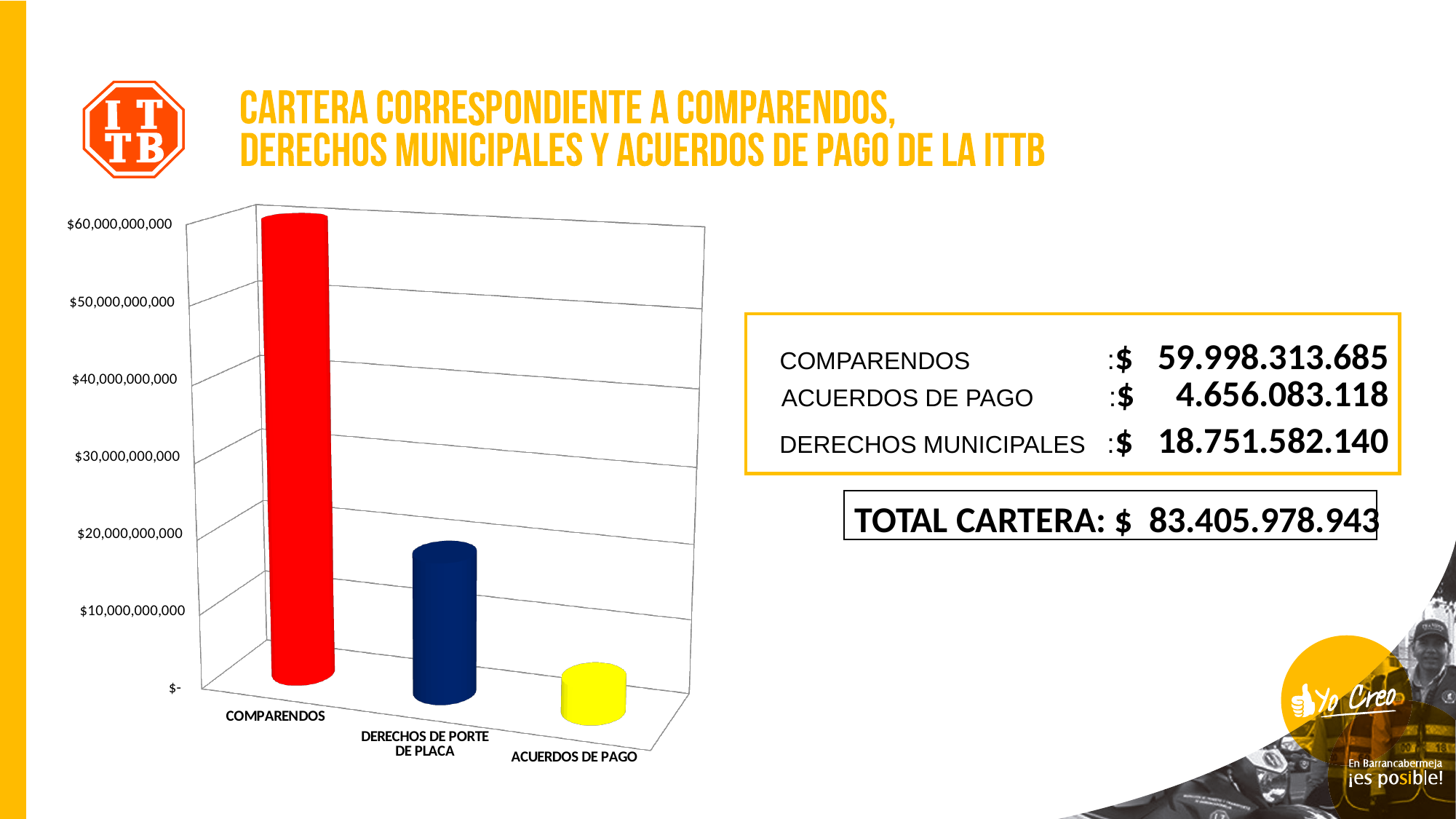
Which category has the lowest bar in the chart? ACUERDOS DE PAGO Which is larger, the bar for COMPARENDOS or the bar for DERECHOS DE PORTE DE PLACA? COMPARENDOS What kind of chart is shown on the slide? Bar chart What colour is the bar for COMPARENDOS? Red According to the slide, what is the cartera value for ACUERDOS DE PAGO? $ 4.656.083.118 How many categories are plotted in the chart? 3 Is the value for COMPARENDOS greater or less than $50,000,000,000? greater Is the value for DERECHOS DE PORTE DE PLACA greater or less than $20,000,000,000? less Which category has the highest bar in the chart? COMPARENDOS Is the value for ACUERDOS DE PAGO greater or less than $10,000,000,000? less According to the slide, what is the cartera value for COMPARENDOS? $ 59.998.313.685 What is the difference between the COMPARENDOS value and the ACUERDOS DE PAGO value shown on the slide? $ 55.342.230.567